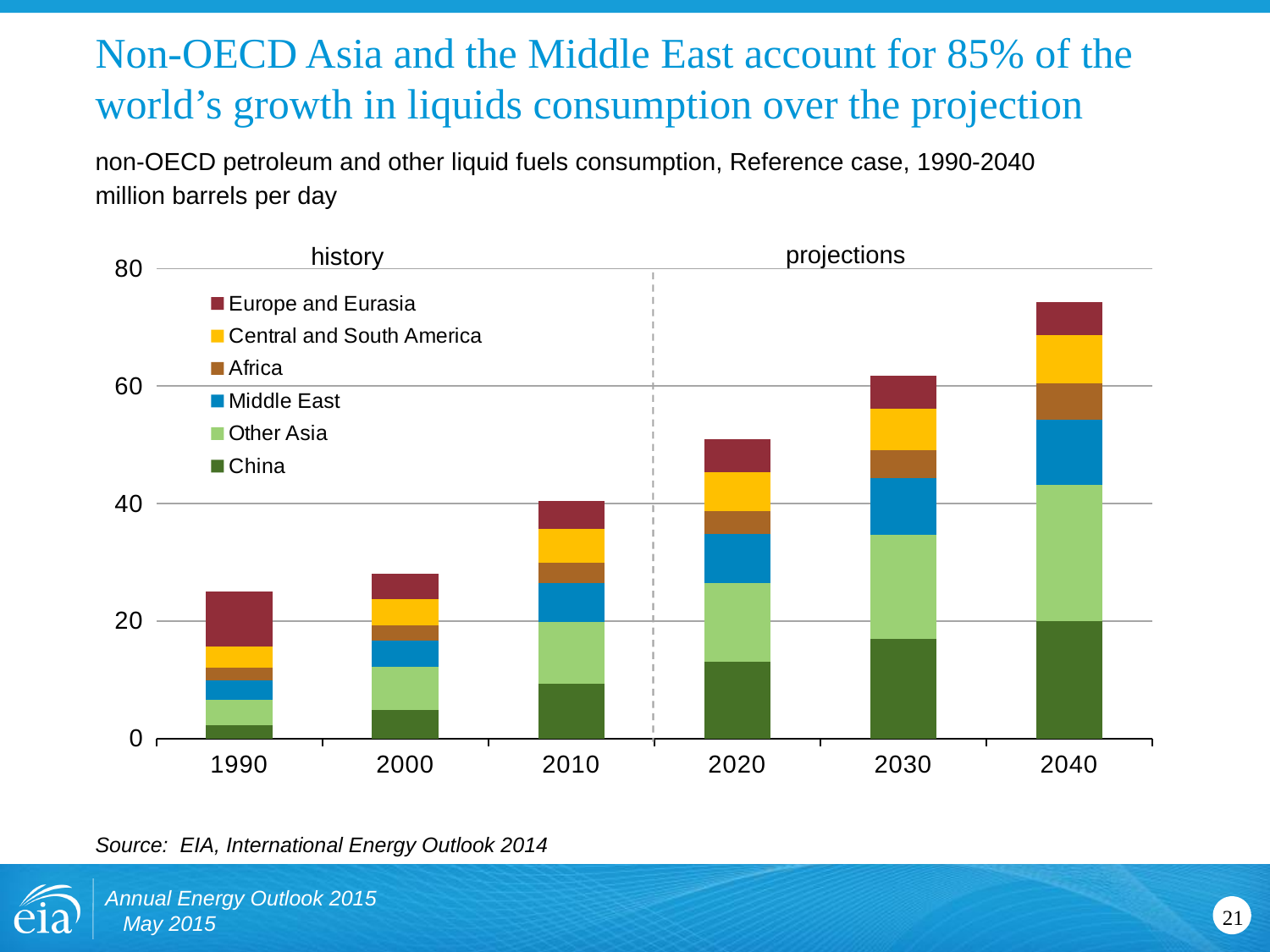
Which year has the highest total non-OECD liquids consumption? 2040 What kind of chart is shown on the slide? stacked bar chart How many years are shown along the x axis of the chart? 6 Which region is listed first in the chart's legend? Europe and Eurasia Is the total value for 2040 greater or less than 60? greater Is the total value for 1990 greater or less than 20? greater Is the total value for 2000 greater or less than 40? less Which year has the lowest total non-OECD liquids consumption? 1990 Which is larger, the total for 2030 or the total for 2010? 2030 Do the total stacked bar heights rise or fall from 1990 to 2040? rise How many series does the chart's legend list? 6